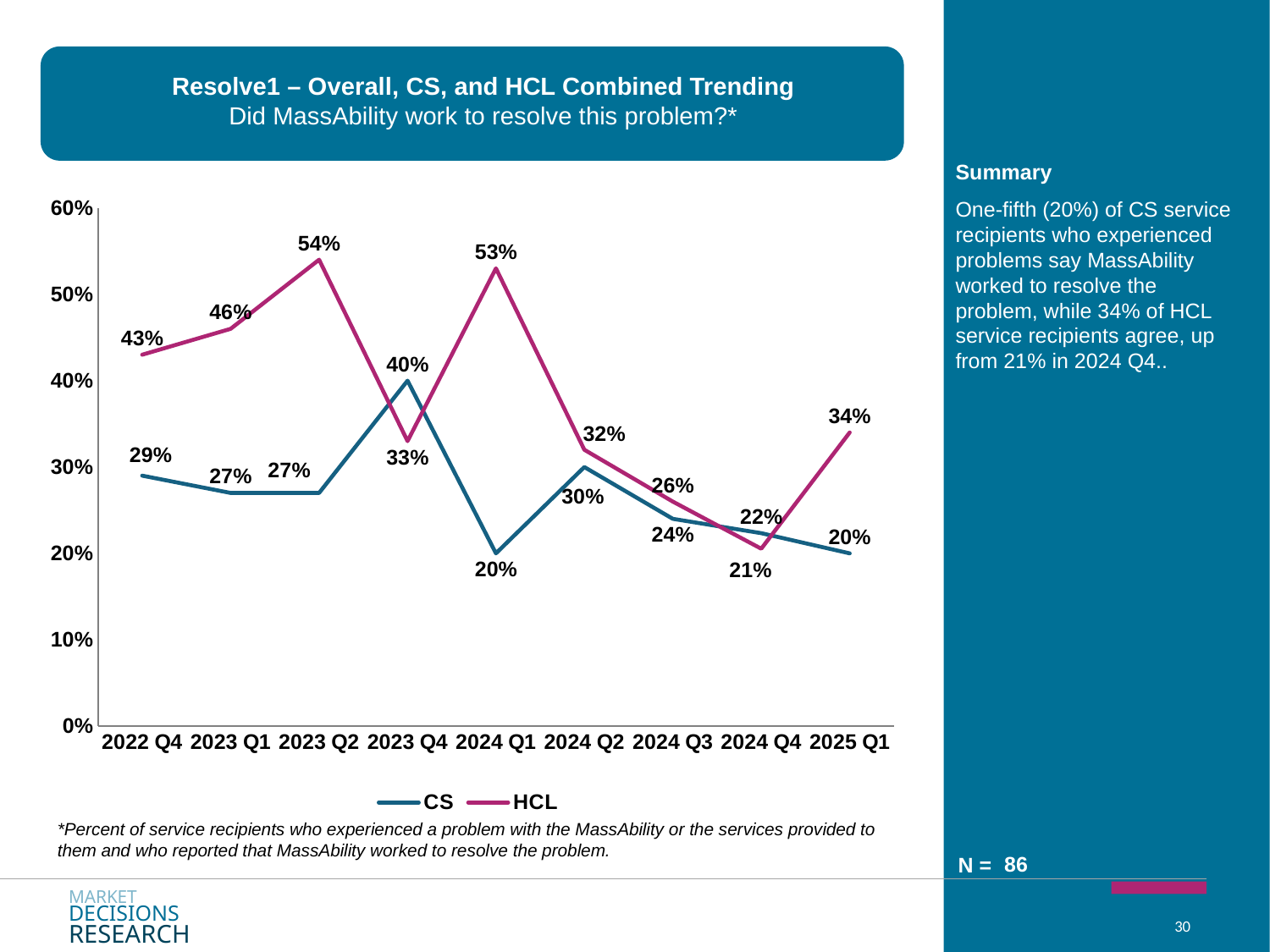
Which series has the larger value in 2023 Q4, CS or HCL? CS What type of chart is shown on the slide? Line chart What is the HCL value for 2023 Q2? 54% What is the CS value for 2024 Q1? 20% What colour is the HCL line in the chart? Magenta In which quarter does the HCL series reach its lowest value? 2024 Q4 What is the HCL value for 2025 Q1? 34% How many series does the legend list? 2 In which quarter does the CS series reach its highest value? 2023 Q4 How many quarters are plotted along the x axis? 9 Does the HCL series rise or fall from 2024 Q4 to 2025 Q1? Rise What is the difference between the HCL and CS values in 2024 Q1? 33%